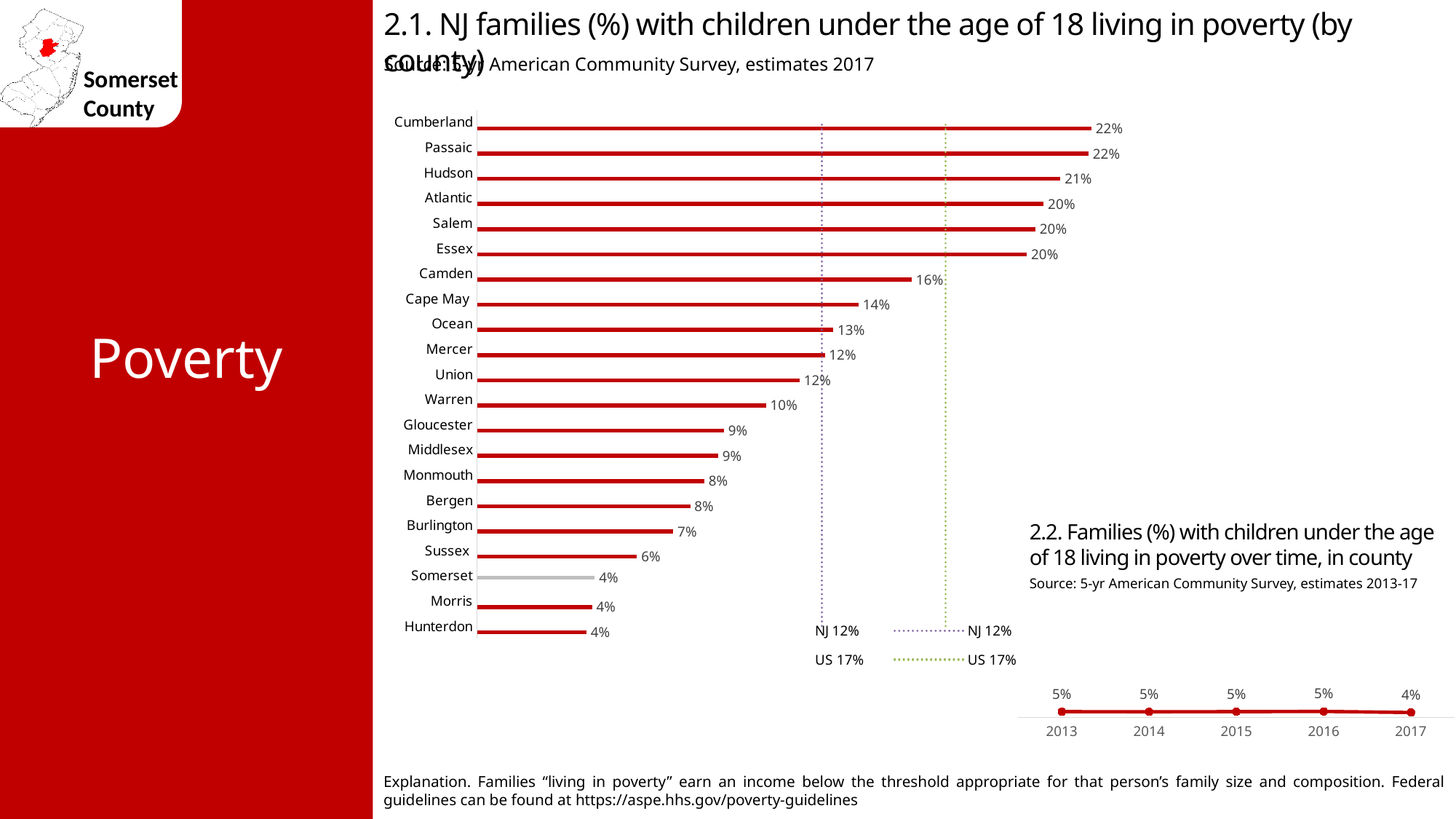
In chart 2.1, what is the value shown for Hudson? 21% In chart 2.1, which has a higher value, Camden or Cape May? Camden In chart 2.1, what is the difference between the values for Cumberland and Somerset? 18 percentage points In chart 2.1, what value is shown for the NJ reference line? 12% In chart 2.2, how many years are plotted? 5 In chart 2.1, what is the value shown for Warren? 10% What kind of chart is chart 2.2? Line chart In chart 2.1, how many counties are plotted? 21 In chart 2.1, what value is shown for the US reference line? 17% In chart 2.1, what is the value shown for Somerset? 4% In chart 2.1, what percentage of families with children under 18 live in poverty in Camden? 16% In chart 2.2, what is the value for 2017? 4%